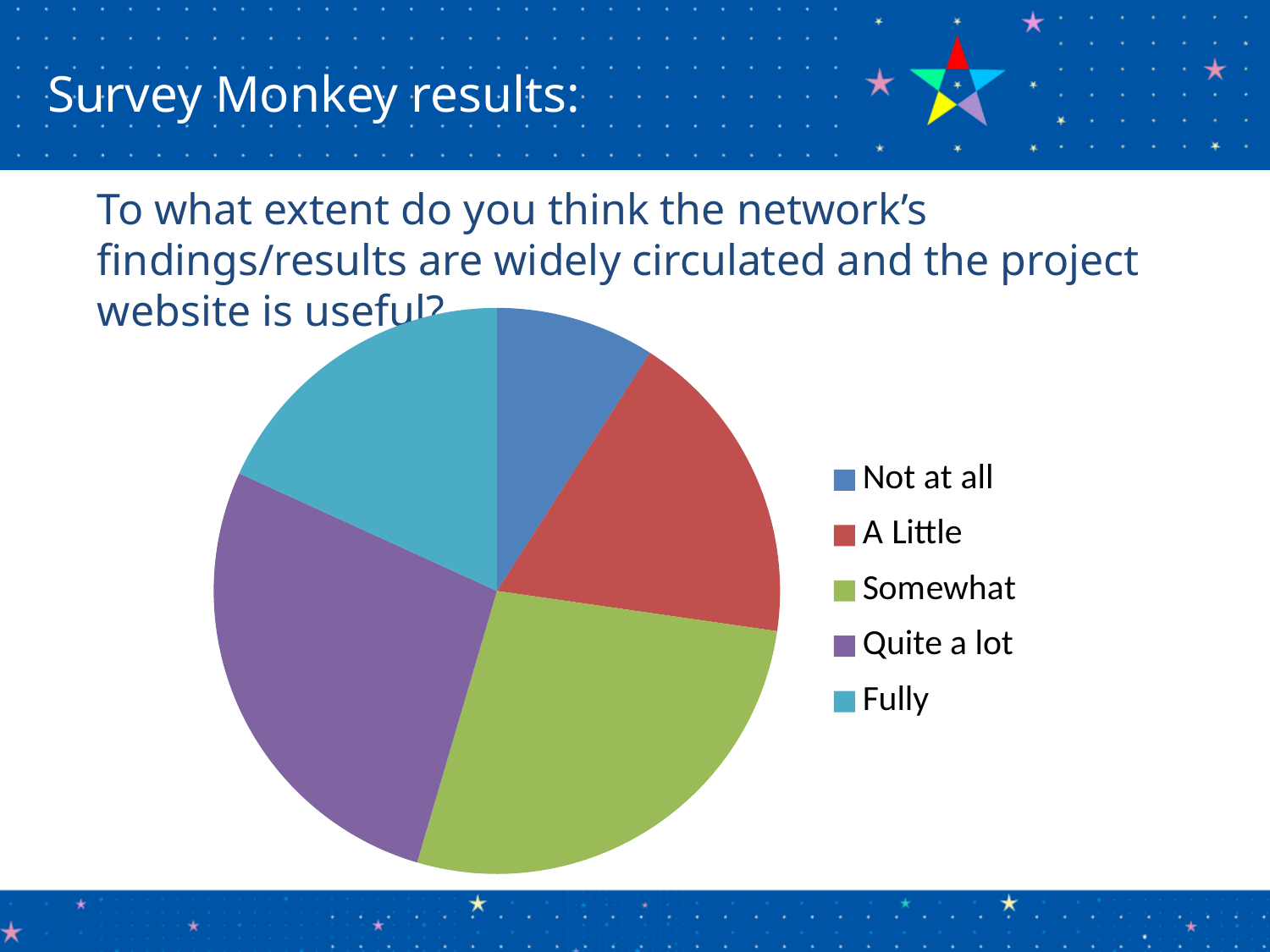
Which legend entry is shown in purple? Quite a lot How many entries does the legend of the pie chart list? 5 How many slices does the pie chart have? 5 Which slice is larger, "Somewhat" or "Not at all"? Somewhat Which slice is larger, "A Little" or "Not at all"? A Little Which slice is larger, "Not at all" or "Fully"? Fully Which response category has the smallest slice of the pie chart? Not at all What colour is the "Somewhat" slice in the pie chart? Green What kind of chart is shown on the slide? Pie chart